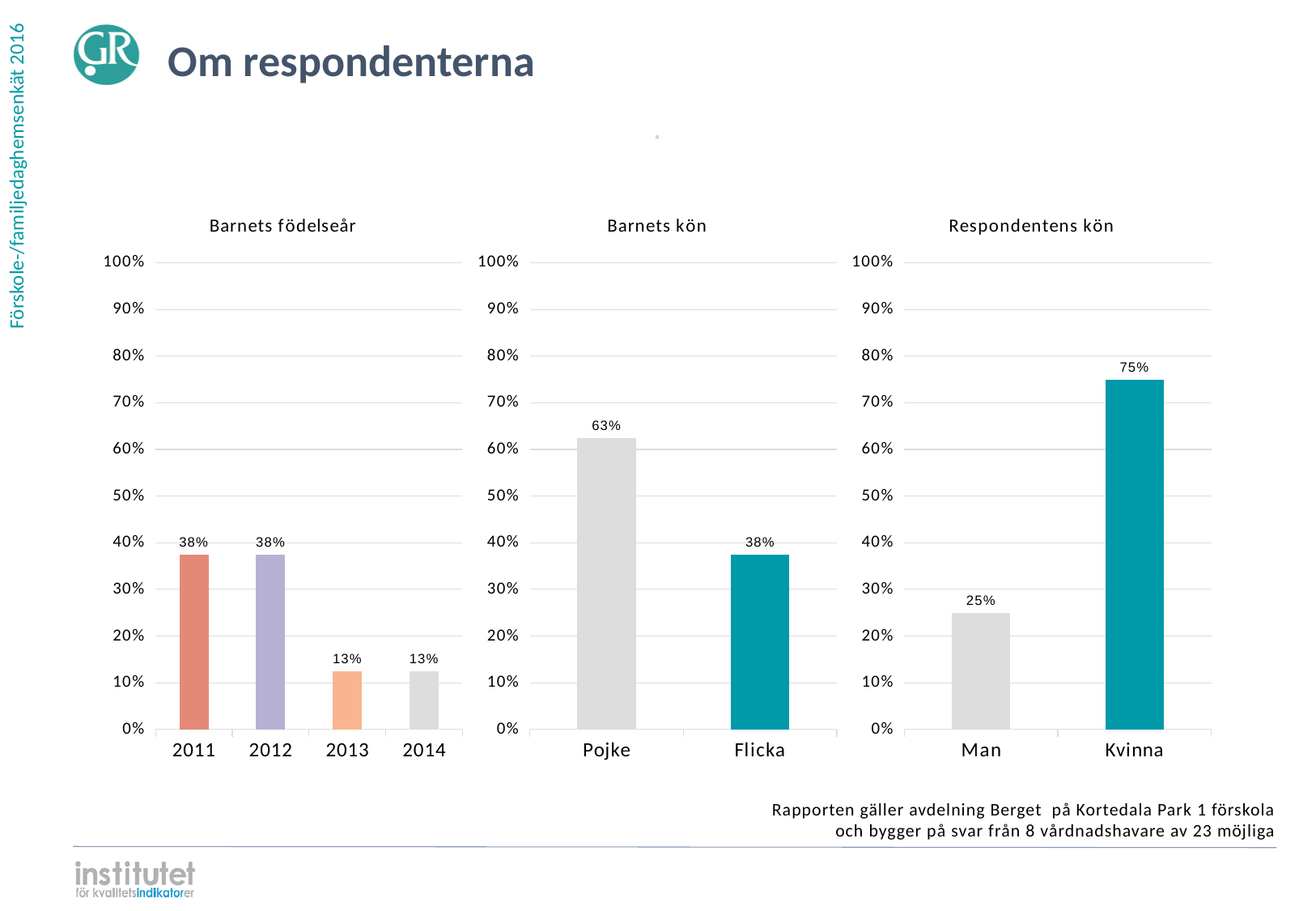
In the 'Respondentens kön' chart, what is the value for Kvinna? 75% In the 'Respondentens kön' chart, which category has the highest value? Kvinna In the 'Barnets kön' chart, what is the value for Pojke? 63% In the 'Barnets kön' chart, which category has the lowest value? Flicka What kind of chart is the 'Barnets kön' chart? Bar chart In the 'Barnets födelseår' chart, what is the value for 2013? 13% In the 'Barnets kön' chart, what is the difference between Pojke and Flicka? 25% In the 'Barnets födelseår' chart, what is the value for 2011? 38% In the 'Respondentens kön' chart, is the value for Man greater or less than 30%? less In the 'Barnets födelseår' chart, what is the difference between the values for 2012 and 2014? 25% In the 'Barnets födelseår' chart, do the values rise or fall from 2012 to 2013? fall In the 'Barnets födelseår' chart, how many categories are shown on the x axis? 4